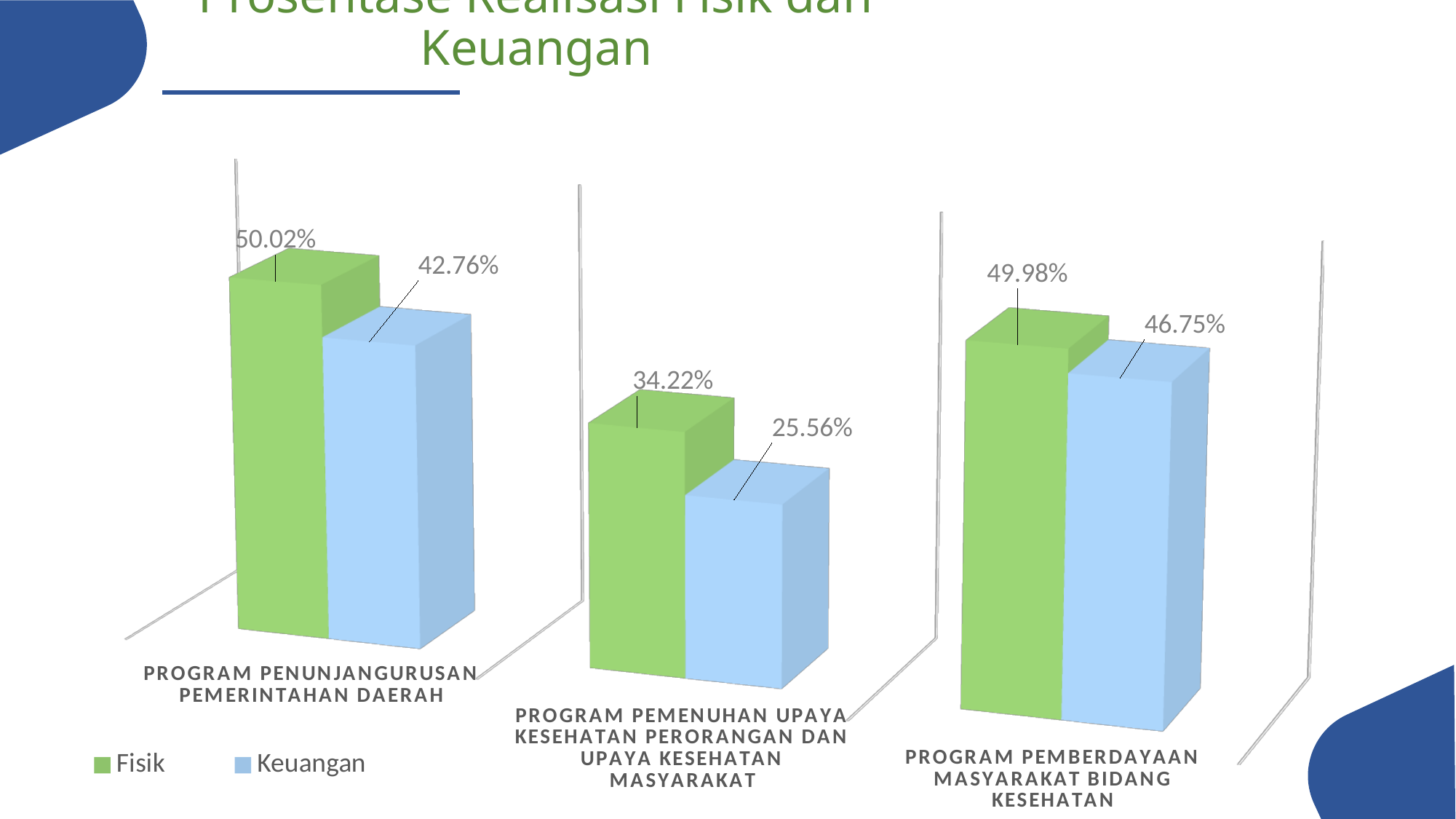
Which program has the lowest Fisik value? Program Pemenuhan Upaya Kesehatan Perorangan dan Upaya Kesehatan Masyarakat How many series does the legend list? 2 What is the Keuangan value for Program Pemberdayaan Masyarakat Bidang Kesehatan? 46.75% What is the Fisik value for Program Penunjang Urusan Pemerintahan Daerah? 50.02% Which is larger for Program Pemenuhan Upaya Kesehatan Perorangan dan Upaya Kesehatan Masyarakat: the Fisik value or the Keuangan value? Fisik What is the Keuangan value for Program Pemenuhan Upaya Kesehatan Perorangan dan Upaya Kesehatan Masyarakat? 25.56% What is the difference between the Fisik and Keuangan values for Program Pemberdayaan Masyarakat Bidang Kesehatan? 3.23% How many programs (categories) are shown in the chart? 3 What kind of chart is shown on the slide? Bar chart Which program has the highest Keuangan value? Program Pemberdayaan Masyarakat Bidang Kesehatan What is the difference between the Fisik and Keuangan values for Program Penunjang Urusan Pemerintahan Daerah? 7.26% What is the Fisik value for Program Pemenuhan Upaya Kesehatan Perorangan dan Upaya Kesehatan Masyarakat? 34.22%